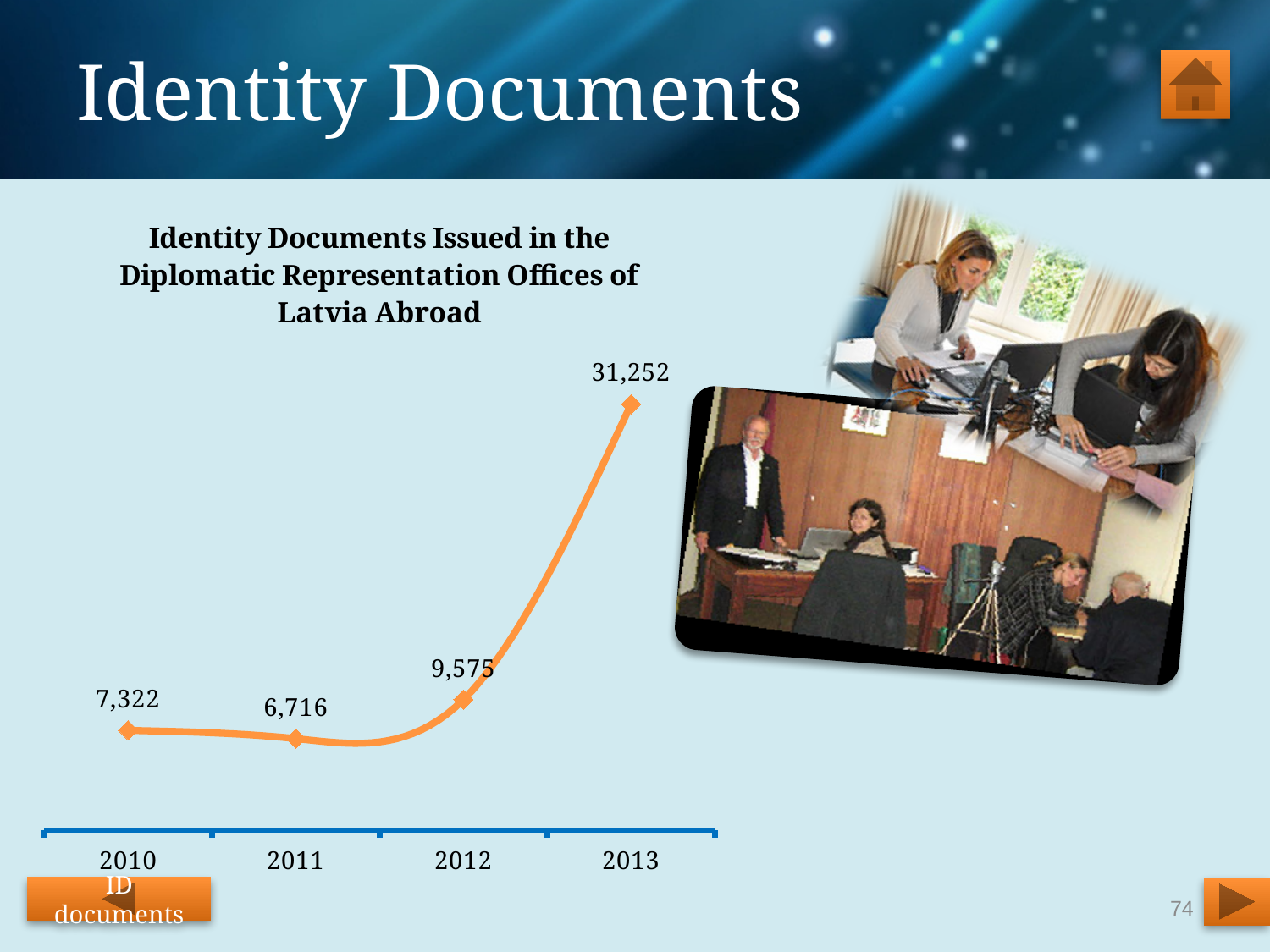
Which is larger, the value for 2010 or the value for 2012? 2012 What value is shown for 2013? 31,252 What kind of chart is shown on the slide? Line chart How many years are plotted on the chart? 4 What is the title of the chart? Identity Documents Issued in the Diplomatic Representation Offices of Latvia Abroad What is the difference between the values for 2010 and 2011? 606 What is the difference between the values for 2013 and 2012? 21,677 Which year has the highest value? 2013 What value is shown for 2012? 9,575 Which year has the lowest value? 2011 What value is shown for 2010? 7,322 What value is shown for 2011? 6,716